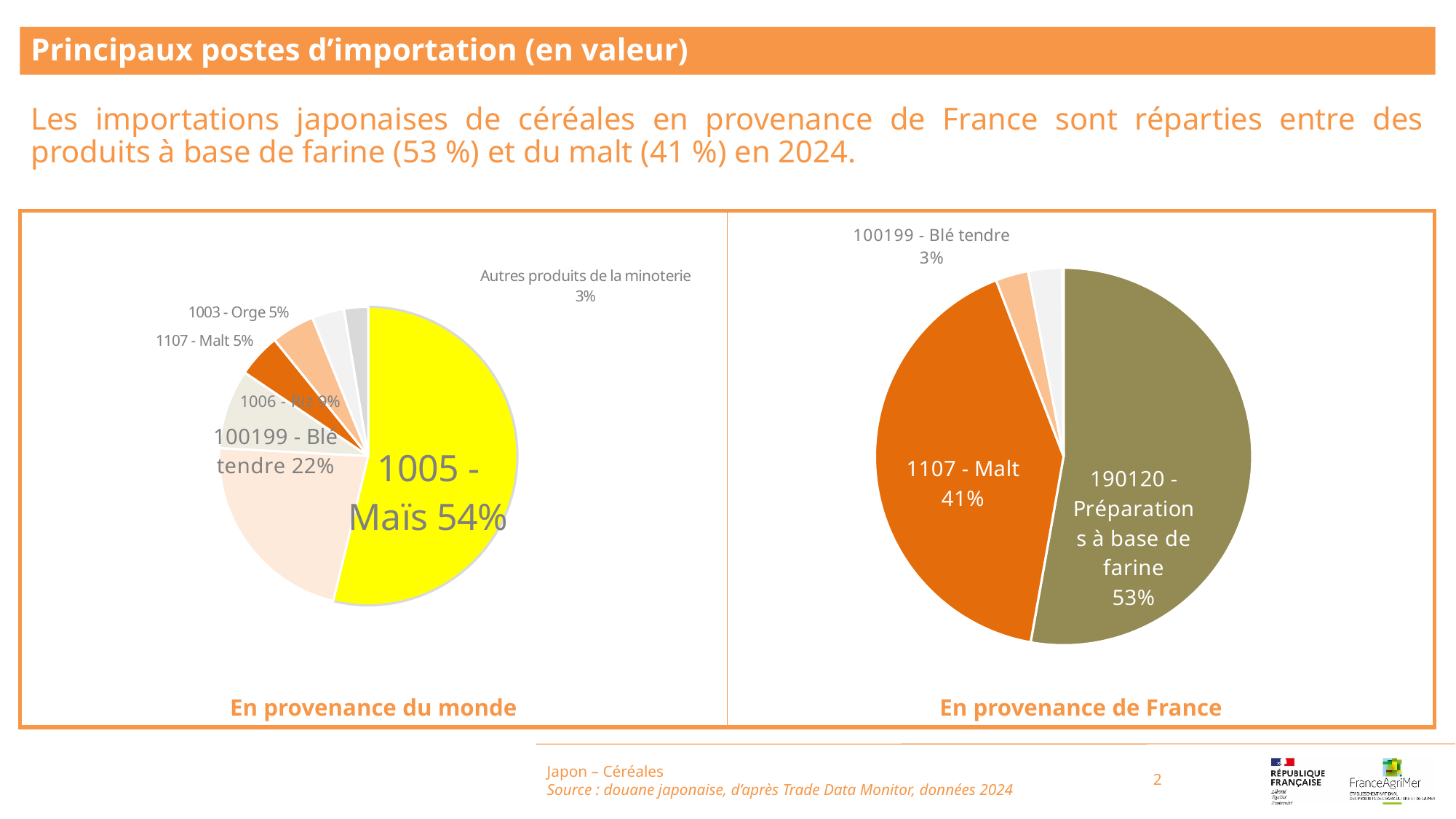
In the pie chart titled 'En provenance de France', which category has the largest slice? 190120 - Préparations à base de farine In the pie chart titled 'En provenance de France', what share does '100199 - Blé tendre' have? 3% In the pie chart titled 'En provenance de France', what share does '1107 - Malt' have? 41% In the pie chart titled 'En provenance du monde', what is the difference in percentage points between '1005 - Maïs' and '100199 - Blé tendre'? 32 percentage points In the pie chart titled 'En provenance du monde', which category has the largest slice? 1005 - Maïs In the pie chart titled 'En provenance de France', what share does '190120 - Préparations à base de farine' have? 53% Is the share of '1107 - Malt' larger in the chart 'En provenance du monde' or in the chart 'En provenance de France'? En provenance de France In the pie chart titled 'En provenance de France', what is the difference in percentage points between '190120 - Préparations à base de farine' and '1107 - Malt'? 12 percentage points What kind of chart is used on the right side of the slide, titled 'En provenance de France'? Pie chart